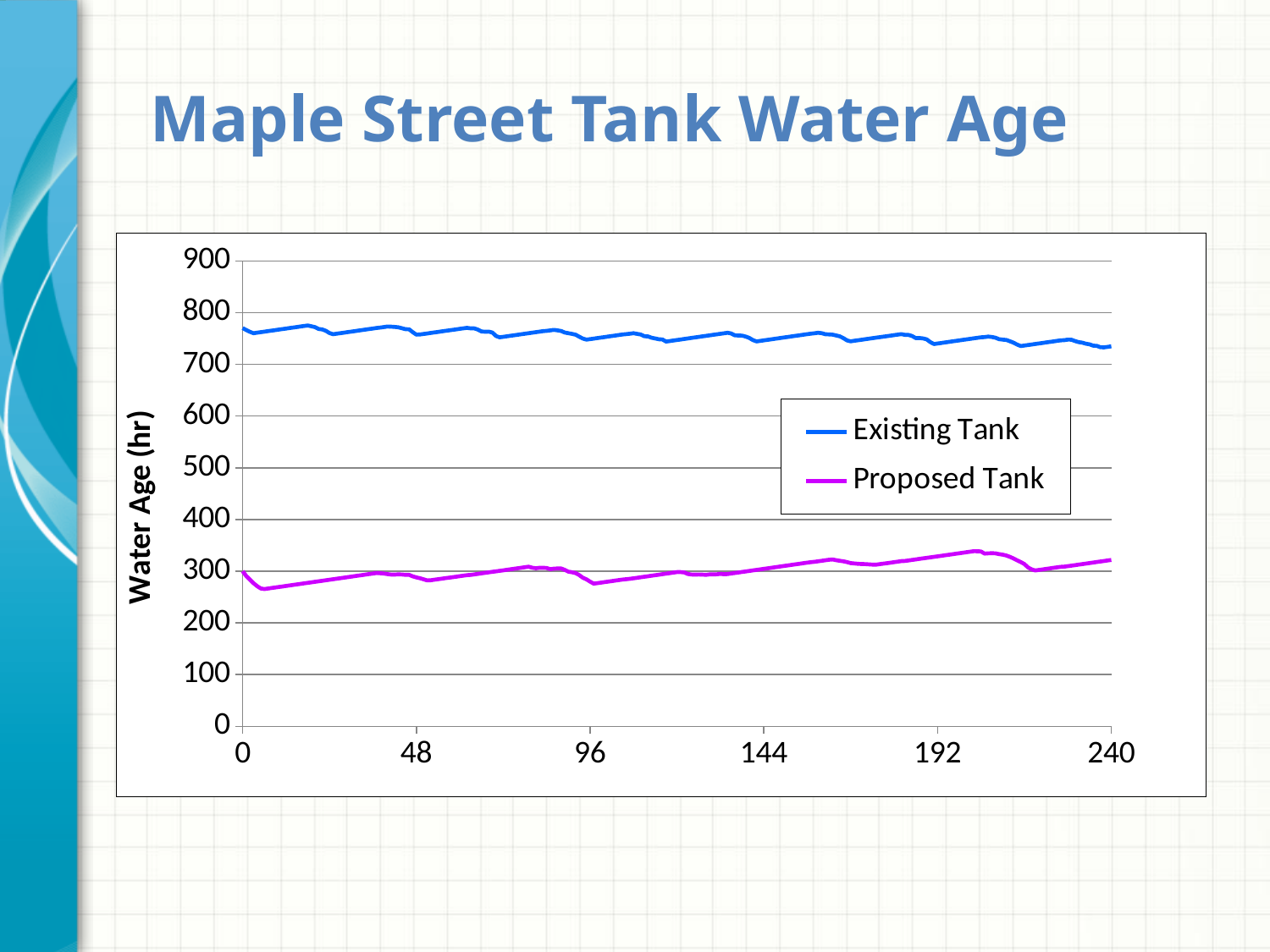
What is the maximum value shown on the vertical axis? 900 Does the Proposed Tank line generally rise or fall from x = 48 to x = 192? rise Is the value for Existing Tank at x = 0 greater or less than 700? greater Is the value for Existing Tank at x = 240 greater or less than 800? less What colour is the Proposed Tank line? magenta How many series does the legend list? 2 Does the Existing Tank line generally rise or fall from x = 0 to x = 240? fall Is the value for Proposed Tank at x = 240 greater or less than 200? greater What kind of chart is shown on the slide? line chart What is the label of the vertical axis? Water Age (hr) Which series has the higher water age throughout the chart, Existing Tank or Proposed Tank? Existing Tank